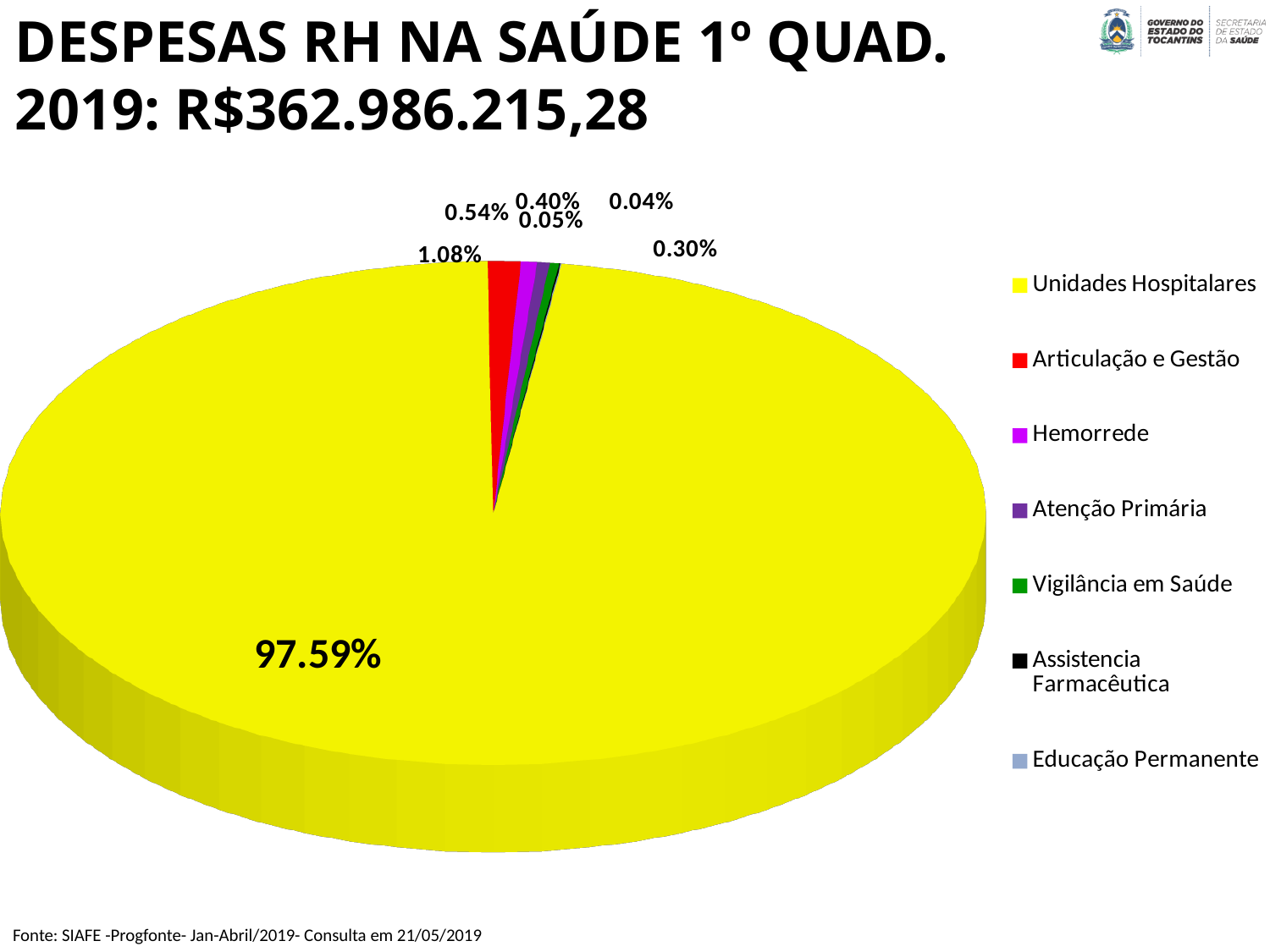
What kind of chart is shown on the slide? pie chart What percentage is shown for Articulação e Gestão? 1.08% What share of the pie does Unidades Hospitalares represent? 97.59% How many categories does the legend list? 7 What is the difference in percentage points between Unidades Hospitalares (97.59%) and Articulação e Gestão (1.08%)? 96.51% Which is larger, the share for Unidades Hospitalares or the share for Articulação e Gestão? Unidades Hospitalares What colour represents Unidades Hospitalares in the legend? yellow What is the largest percentage label shown on the pie chart? 97.59% Which category has the largest share of the pie? Unidades Hospitalares What is the smallest percentage label shown on the pie chart? 0.04% What total amount is stated in the slide title for RH expenses in health, 1st quarter 2019? R$362.986.215,28